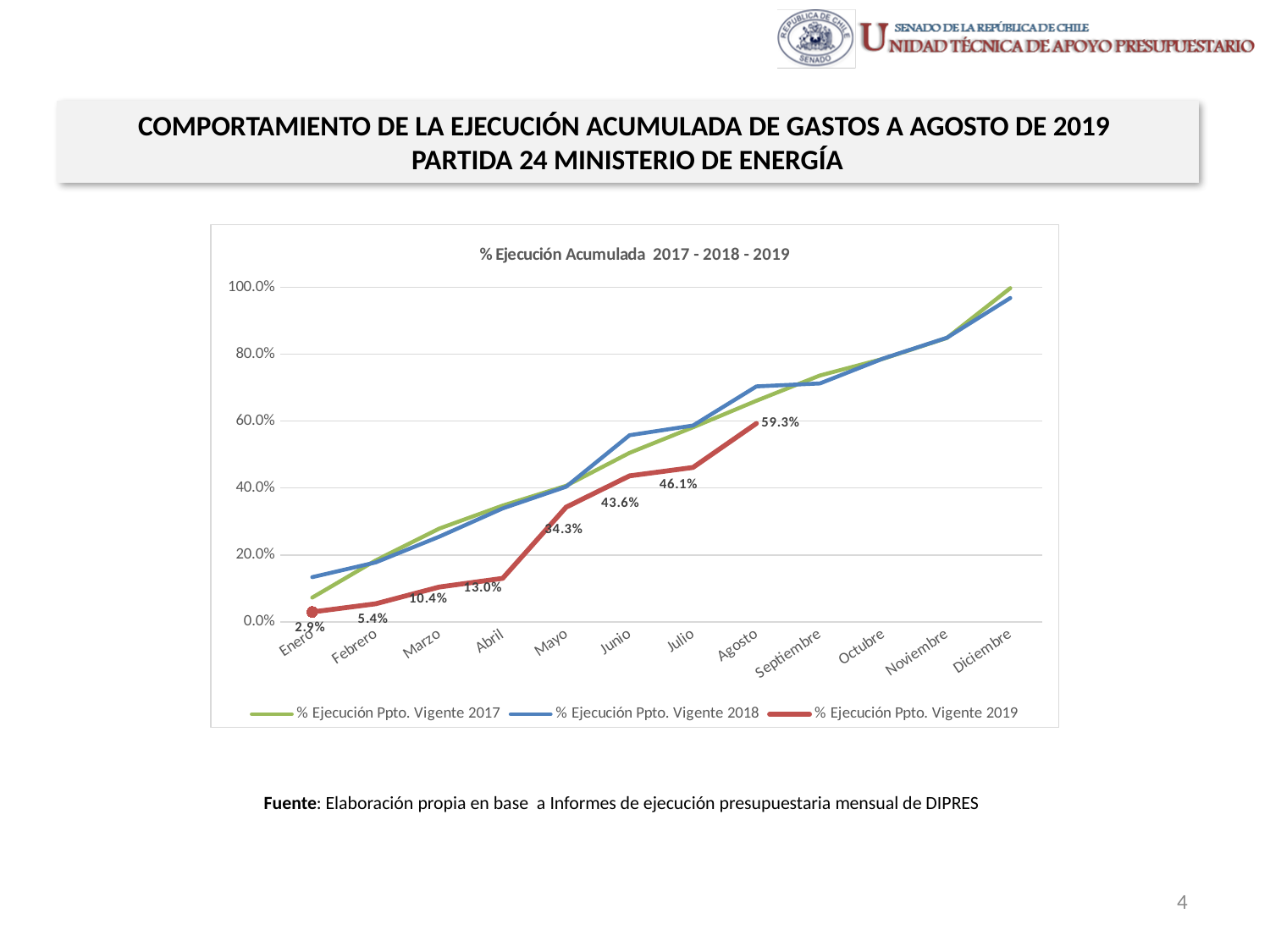
What is the value of % Ejecución Ppto. Vigente 2019 in Mayo? 34.3% What type of chart is shown on the slide? line chart What is the difference between the 2019 values for Agosto and Julio? 13.2% What is the value of % Ejecución Ppto. Vigente 2019 in Agosto? 59.3% Does the % Ejecución Ppto. Vigente 2019 series rise or fall from Enero to Agosto? rise Which month has the highest value for the % Ejecución Ppto. Vigente 2019 series? Agosto How many months are shown on the x axis? 12 What is the value of % Ejecución Ppto. Vigente 2019 in Enero? 2.9% What is the difference between the 2019 values for Mayo and Abril? 21.3% What is the title of the chart? % Ejecución Acumulada 2017 - 2018 - 2019 How many series does the legend list? 3 Is the value for % Ejecución Ppto. Vigente 2018 in Junio greater or less than 40.0%? greater